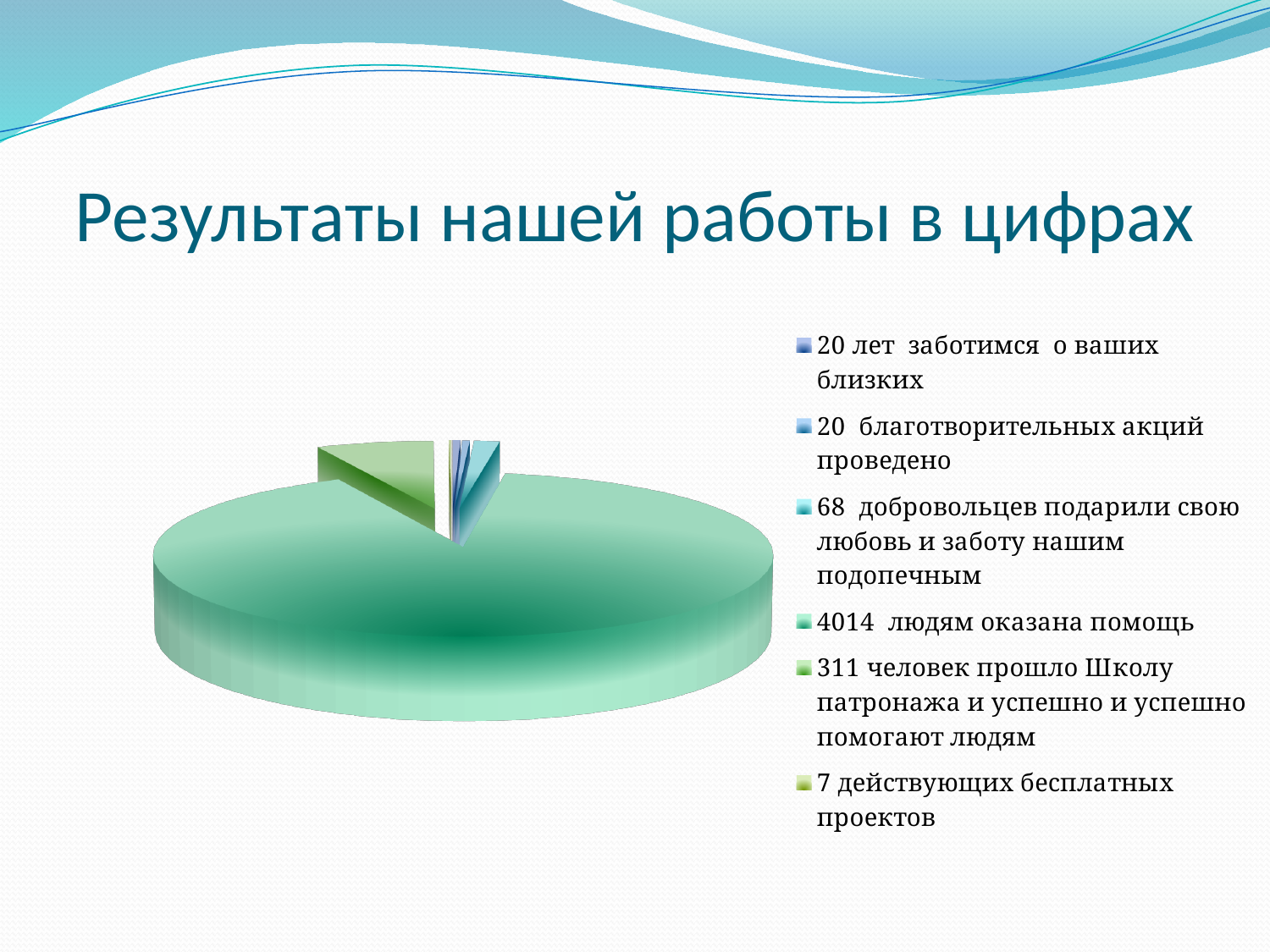
According to the legend, how many people completed the Patronage School (Школу патронажа)? 311 How many entries does the chart's legend list? 6 According to the legend, how many people received help (людям оказана помощь)? 4014 What is the title of the slide containing the chart? Результаты нашей работы в цифрах According to the legend, how many active free projects (действующих бесплатных проектов) are there? 7 What kind of chart is shown on the slide? Pie chart How many slices does the pie chart have? 6 According to the legend, how many volunteers (добровольцев) gave their love and care? 68 What is the difference between the number of people who completed the Patronage School (311) and the number of volunteers (68)? 243 What colour is the largest slice of the pie chart? Green Which legend entry corresponds to the largest slice of the pie? 4014 людям оказана помощь Which is larger: the number of people who received help (4014) or the number who completed the Patronage School (311)? 4014 людям оказана помощь